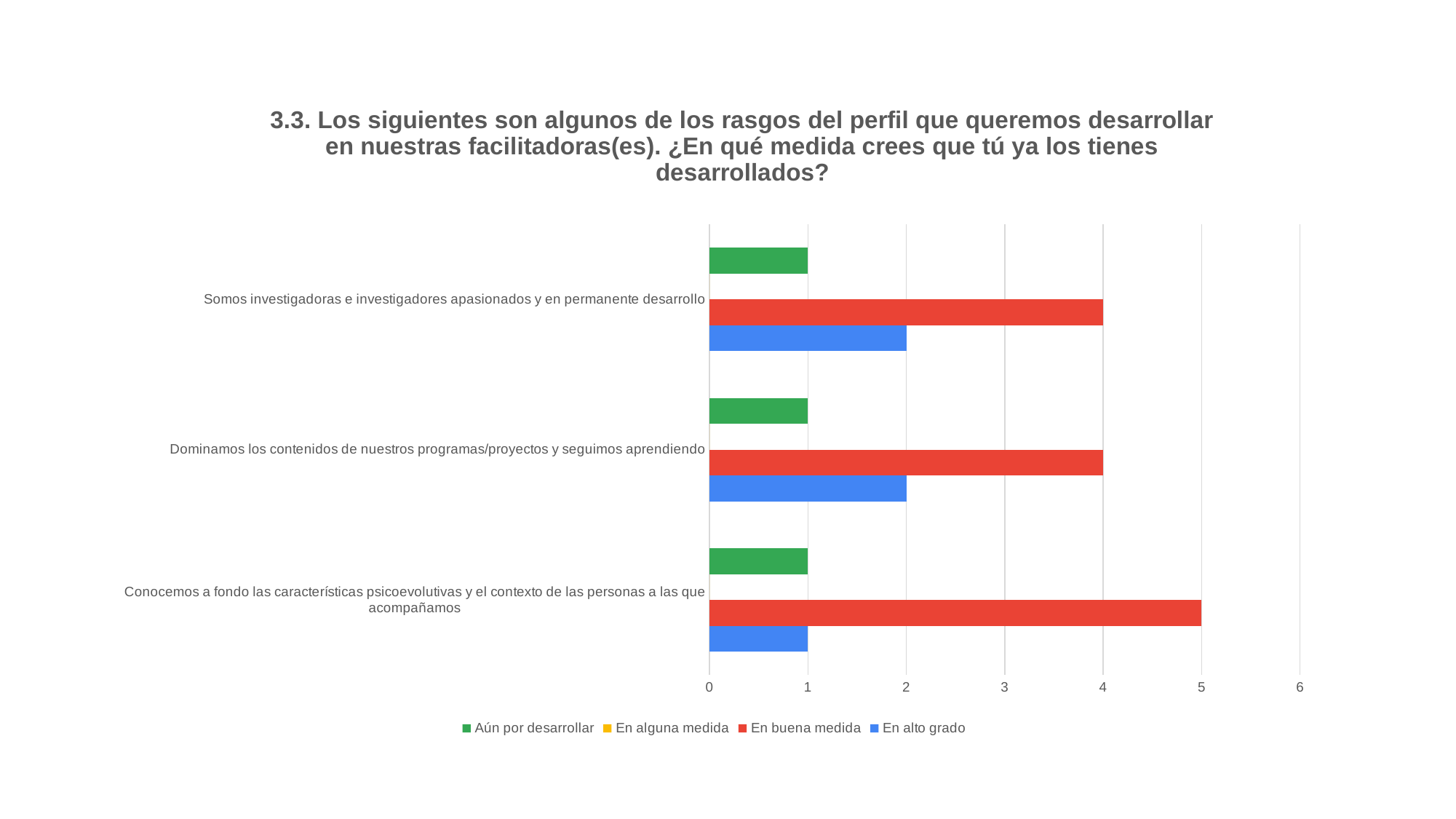
Which category has the lowest value for 'En alto grado'? Conocemos a fondo las características psicoevolutivas y el contexto de las personas a las que acompañamos Which legend series is shown in red? En buena medida For 'Dominamos los contenidos de nuestros programas/proyectos y seguimos aprendiendo', which is larger: 'En buena medida' or 'En alto grado'? En buena medida What is the value of 'En buena medida' for 'Dominamos los contenidos de nuestros programas/proyectos y seguimos aprendiendo'? 4 What is the value of 'En buena medida' for 'Conocemos a fondo las características psicoevolutivas y el contexto de las personas a las que acompañamos'? 5 How many series does the legend list? 4 What is the value of 'Aún por desarrollar' for 'Dominamos los contenidos de nuestros programas/proyectos y seguimos aprendiendo'? 1 What kind of chart is shown on the slide? bar chart How many categories are plotted on the chart? 3 What is the value of 'En alto grado' for 'Somos investigadoras e investigadores apasionados y en permanente desarrollo'? 2 What is the difference between 'En buena medida' and 'En alto grado' for 'Somos investigadoras e investigadores apasionados y en permanente desarrollo'? 2 Which category has the highest value for 'En buena medida'? Conocemos a fondo las características psicoevolutivas y el contexto de las personas a las que acompañamos